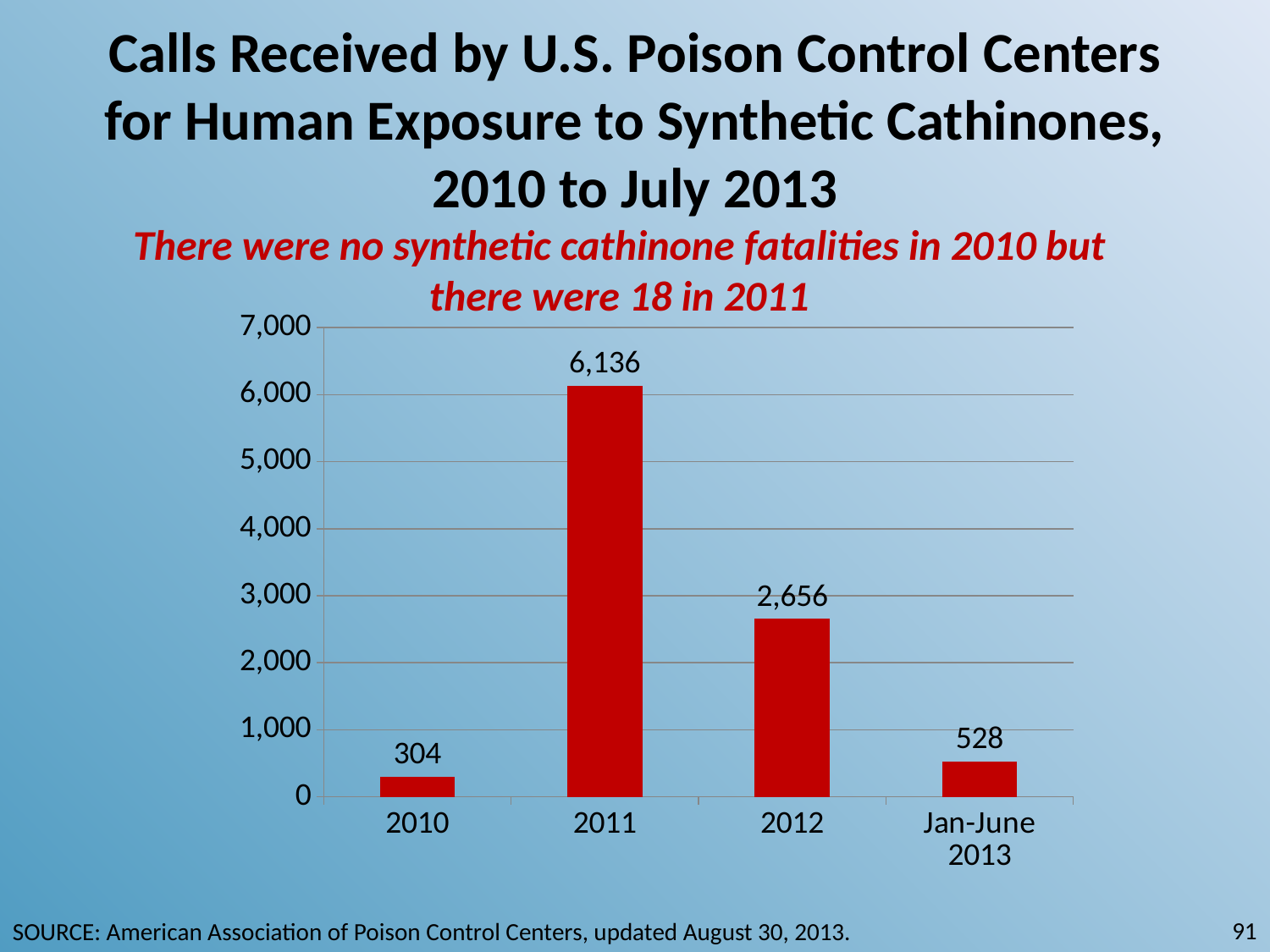
How many calls were received in 2011? 6,136 What is the difference between the 2011 and 2012 values? 3,480 What colour are the bars in the chart? red Is the value for 2012 greater or less than 3,000? less Which is larger, the value for 2012 or the value for Jan-June 2013? 2012 Do the values rise or fall from 2011 to Jan-June 2013? fall What is the value shown for 2010? 304 How many categories are shown on the x axis? 4 Which category has the lowest value? 2010 What kind of chart is this? bar chart How many calls are shown for Jan-June 2013? 528 Which year has the highest number of calls? 2011